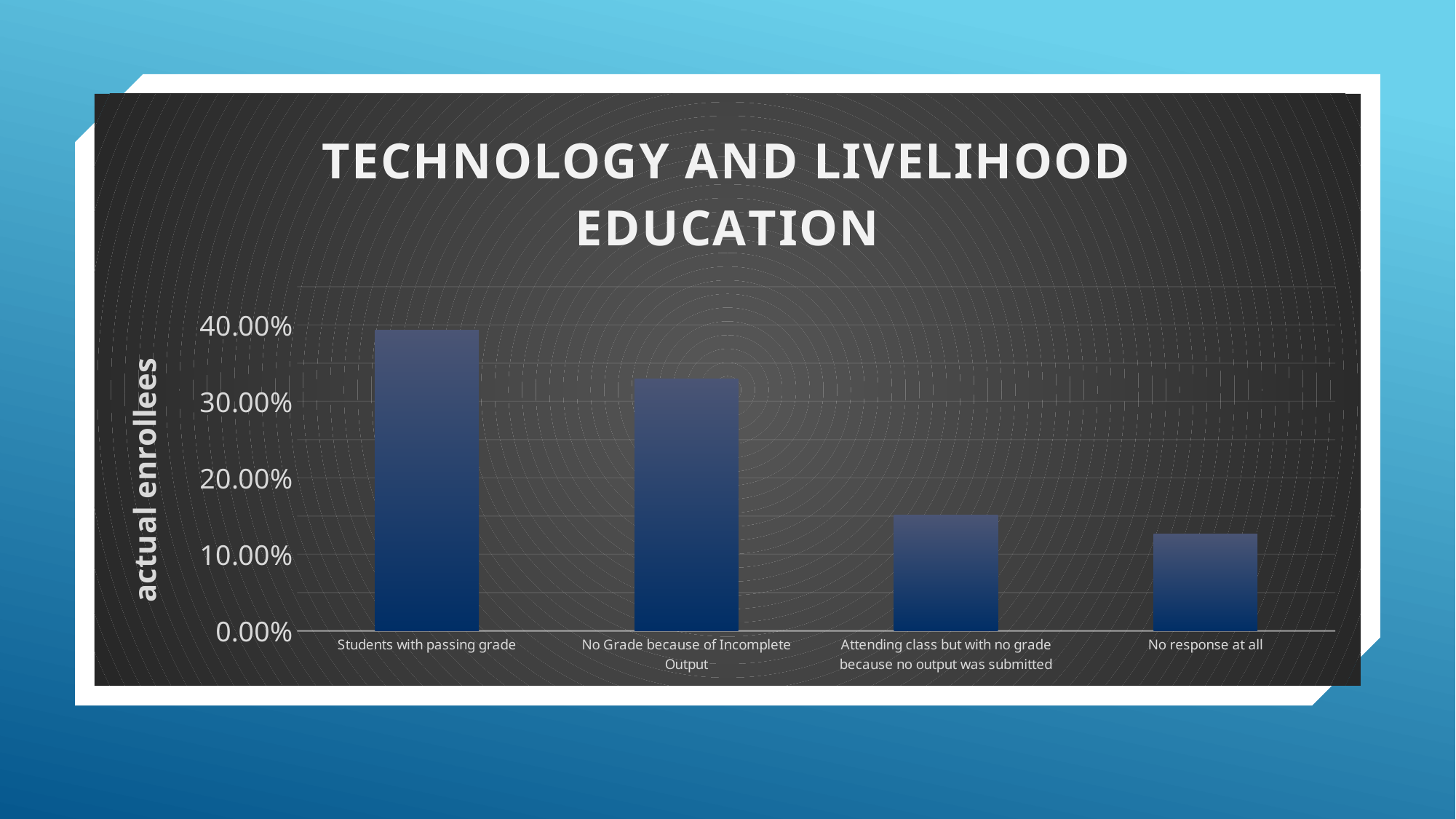
What is the title of the chart? TECHNOLOGY AND LIVELIHOOD EDUCATION Which category has the highest value? Students with passing grade Which category has the lowest value? No response at all How many categories are plotted in the chart? 4 What is the label on the vertical axis of the chart? actual enrollees Is the value for No response at all greater or less than 10.00%? greater Do the values rise or fall moving from left to right across the categories? fall Is the value for Students with passing grade greater or less than 30.00%? greater Which is larger: the value for Students with passing grade or the value for No Grade because of Incomplete Output? Students with passing grade Is the value for No Grade because of Incomplete Output greater or less than 40.00%? less What kind of chart is shown on the slide? bar chart